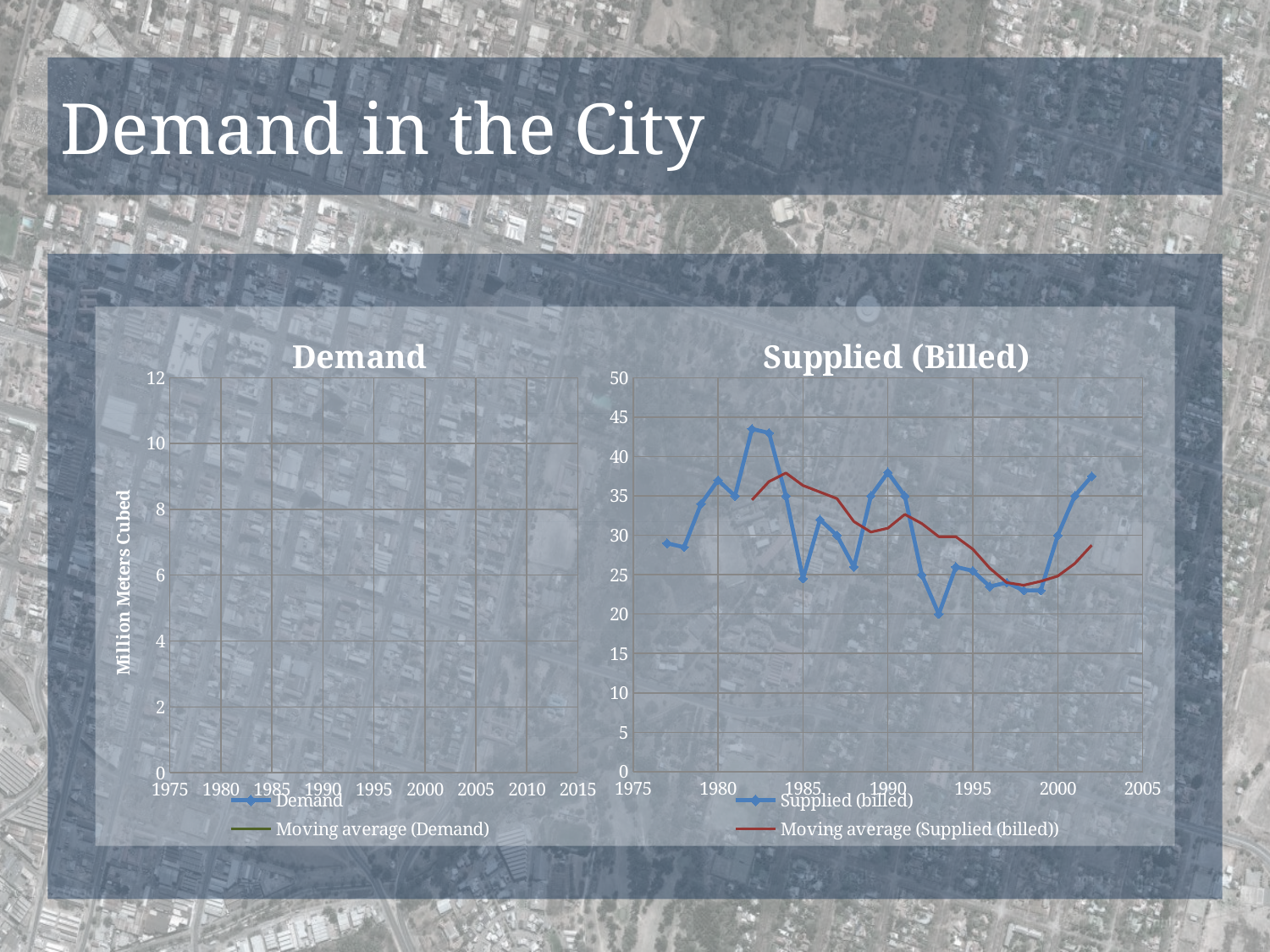
In the "Supplied (Billed)" chart, is the Supplied (billed) value for 1985 greater or less than 30? less In the "Supplied (Billed)" chart, in which year does the Supplied (billed) series reach its highest value? 1982 How many series does the legend of the "Supplied (Billed)" chart list? 2 What kind of chart is the "Supplied (Billed)" chart? line chart In the "Supplied (Billed)" chart, in which year does the Supplied (billed) series reach its lowest value? 1993 In the "Supplied (Billed)" chart, does the Supplied (billed) series rise or fall between 1999 and 2002? rise In the "Supplied (Billed)" chart, which year has the larger Supplied (billed) value, 1985 or 1990? 1990 In the "Supplied (Billed)" chart, is the Supplied (billed) value for 1990 greater or less than 35? greater What is the y-axis title of the "Demand" chart? Million Meters Cubed How many series does the legend of the "Demand" chart list? 2 In the "Supplied (Billed)" chart, is the Supplied (billed) value for 1982 greater or less than 40? greater